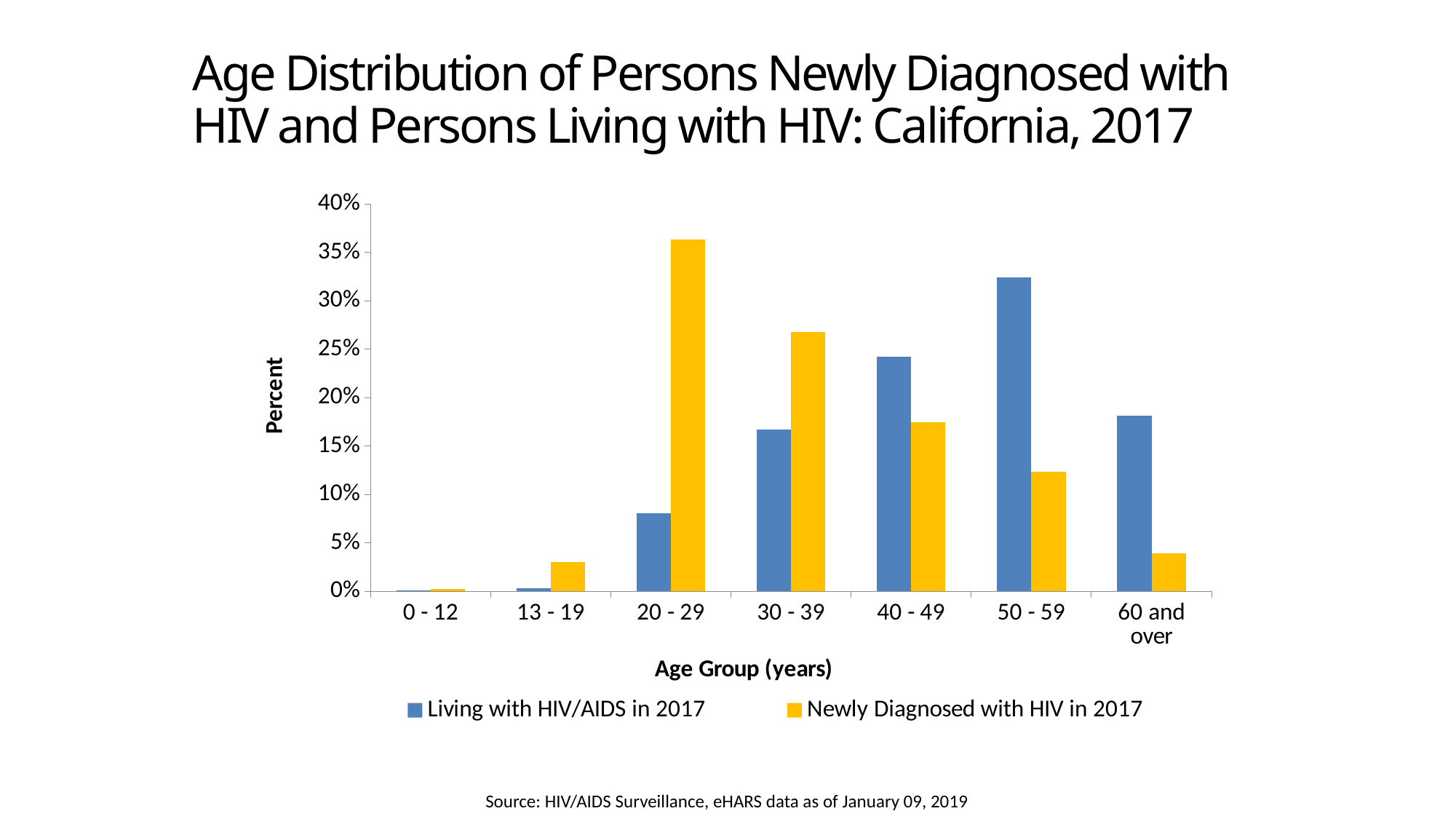
Is the value for Living with HIV/AIDS in 2017 in the 50 - 59 age group greater or less than 30%? greater Which age group has the highest value for Living with HIV/AIDS in 2017? 50 - 59 What kind of chart is shown on the slide? bar chart How many series does the legend list? 2 In the 40 - 49 age group, which series has the larger value: Living with HIV/AIDS in 2017 or Newly Diagnosed with HIV in 2017? Living with HIV/AIDS in 2017 Which age group has the lowest value for Newly Diagnosed with HIV in 2017? 0 - 12 What is the label on the y axis of the chart? Percent Is the value for Living with HIV/AIDS in 2017 in the 60 and over age group greater or less than 20%? less How many age groups are shown on the x axis? 7 In the 30 - 39 age group, which series has the larger value: Living with HIV/AIDS in 2017 or Newly Diagnosed with HIV in 2017? Newly Diagnosed with HIV in 2017 Which age group has the highest value for Newly Diagnosed with HIV in 2017? 20 - 29 Is the value for Newly Diagnosed with HIV in 2017 in the 20 - 29 age group greater or less than 35%? greater